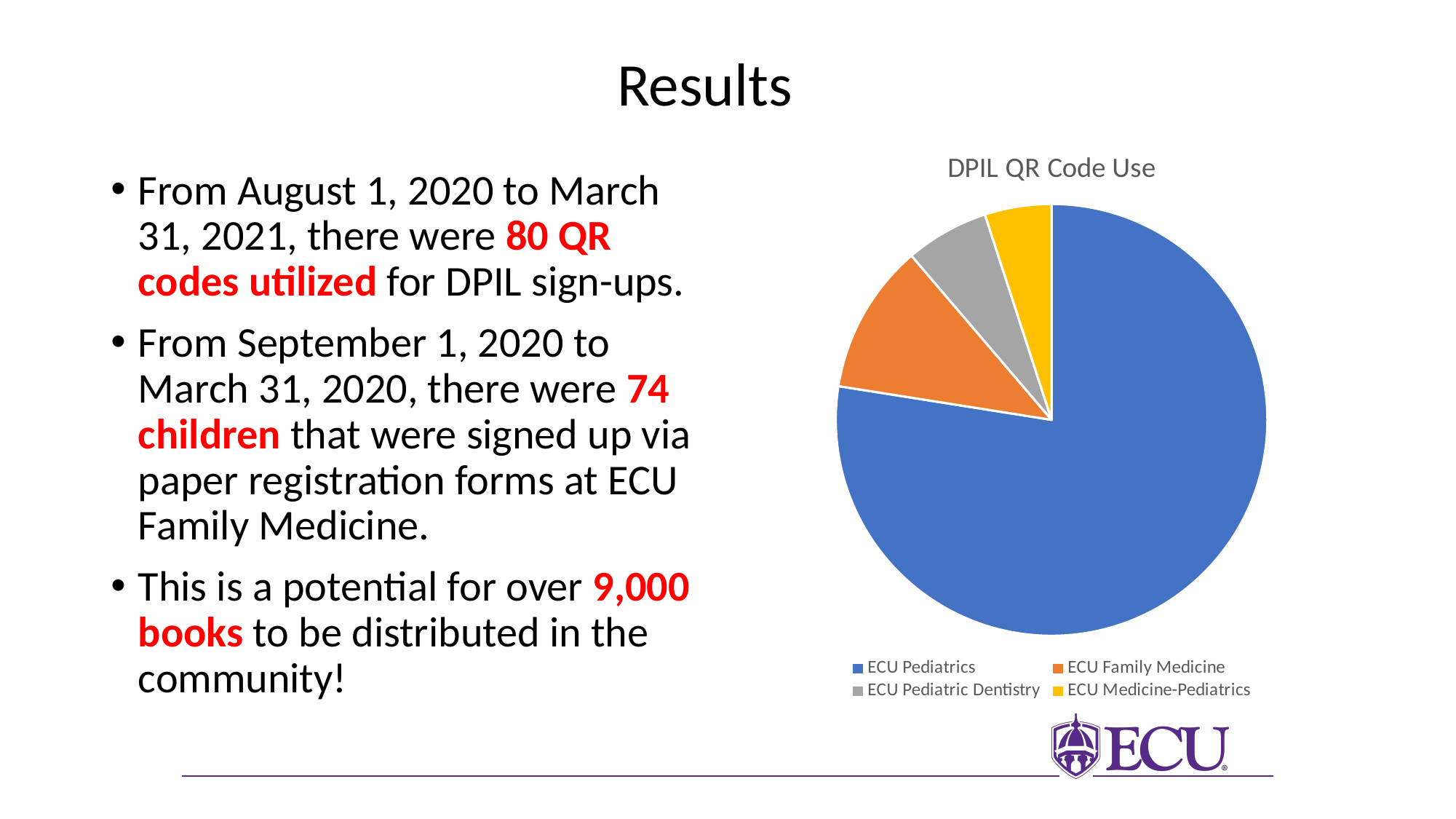
How many entries does the chart's legend list? 4 Which category has the largest slice of the pie chart? ECU Pediatrics Which colour represents ECU Pediatrics in the pie chart? blue Which slice is larger, ECU Pediatrics or ECU Family Medicine? ECU Pediatrics How many categories (slices) does the pie chart have? 4 Which slice is larger, ECU Family Medicine or ECU Medicine-Pediatrics? ECU Family Medicine What is the title of the chart? DPIL QR Code Use Which slice is larger, ECU Pediatrics or ECU Medicine-Pediatrics? ECU Pediatrics What kind of chart is shown on the slide? pie chart